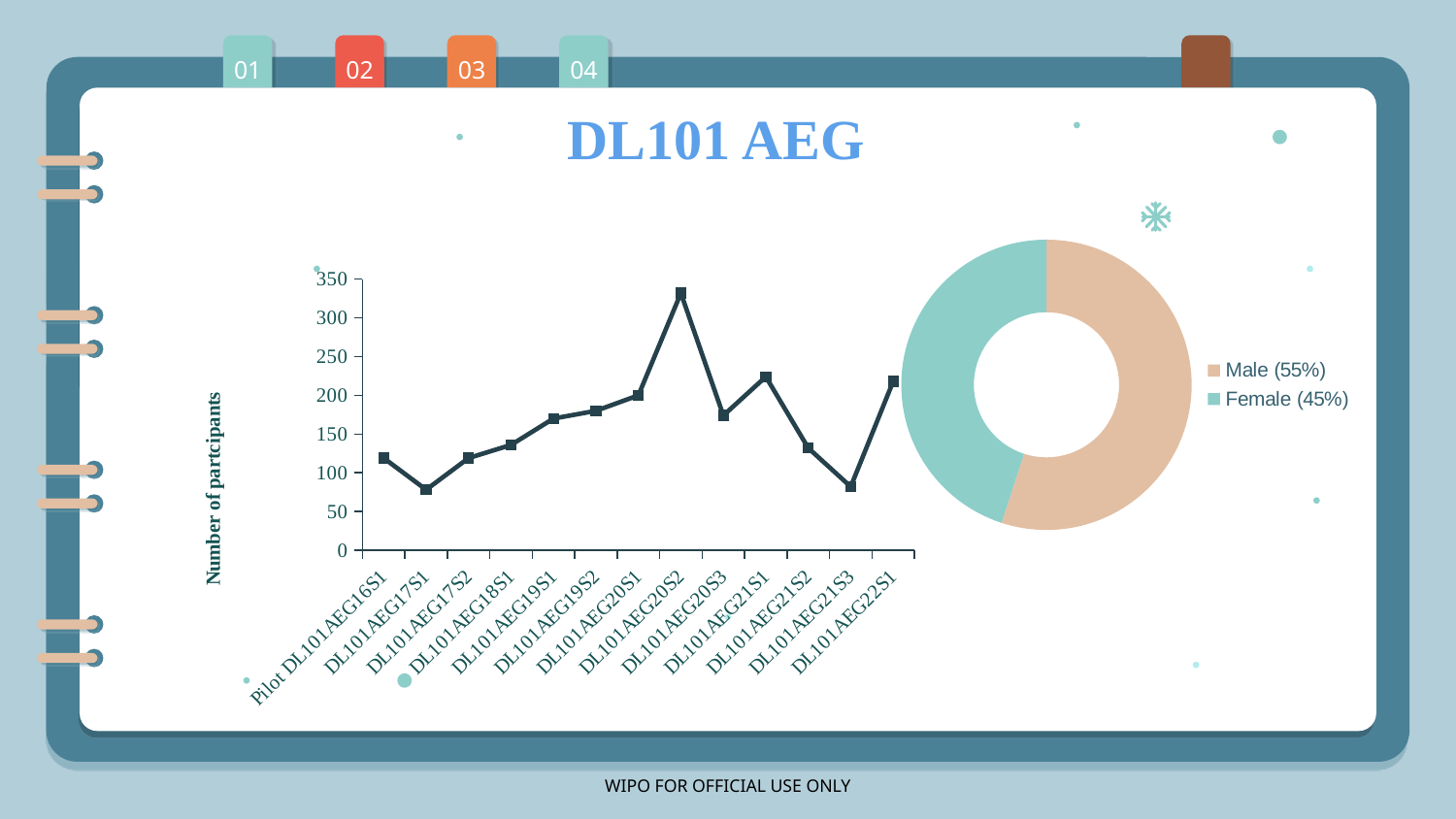
On the line chart, which has more participants, DL101AEG21S1 or DL101AEG21S2? DL101AEG21S1 On the line chart, is the value for DL101AEG17S1 greater or less than 100? less On the pie chart, which slice is larger, Male or Female? Male On the pie chart, what is the difference between the Male and Female shares? 10% On the line chart, which session has the highest number of participants? DL101AEG20S2 On the line chart, is the value for DL101AEG20S2 greater or less than 300? greater On the line chart, do the values rise or fall from DL101AEG17S1 to DL101AEG20S2? rise On the line chart, which has more participants, DL101AEG20S2 or DL101AEG20S3? DL101AEG20S2 On the line chart, is the value for DL101AEG21S1 greater or less than 200? greater How many sessions are plotted on the line chart? 13 On the pie chart, what share is Male? 55%